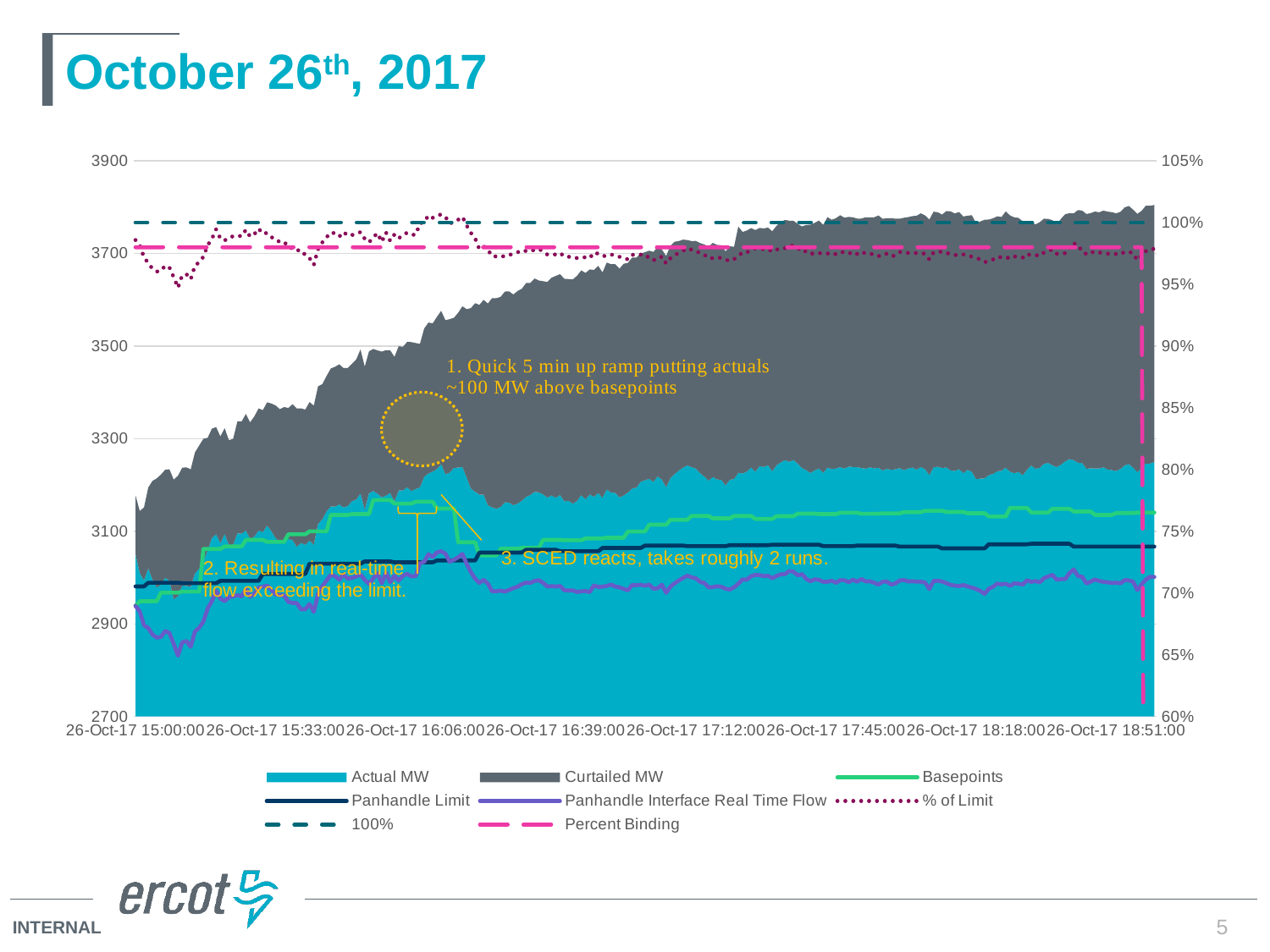
What is the highest value shown on the right y axis? 105% Does the top of the Curtailed MW area rise or fall from 15:00:00 to 18:51:00? rises Is the Percent Binding dashed line greater or less than 95% on the right axis? greater How many series does the chart legend list? 8 Which series is drawn as the light blue (cyan) filled area? Actual MW Is the Panhandle Interface Real Time Flow value at the start of the period (15:00:00) greater or less than 3100? less What kind of chart is shown on the slide? Combined stacked area and line chart Is the Panhandle Limit value at the end of the period (18:51:00) greater or less than 3100? less Which series is drawn as the dark gray filled area? Curtailed MW What is the highest value shown on the left y axis? 3900 How many time labels are shown along the x axis? 8